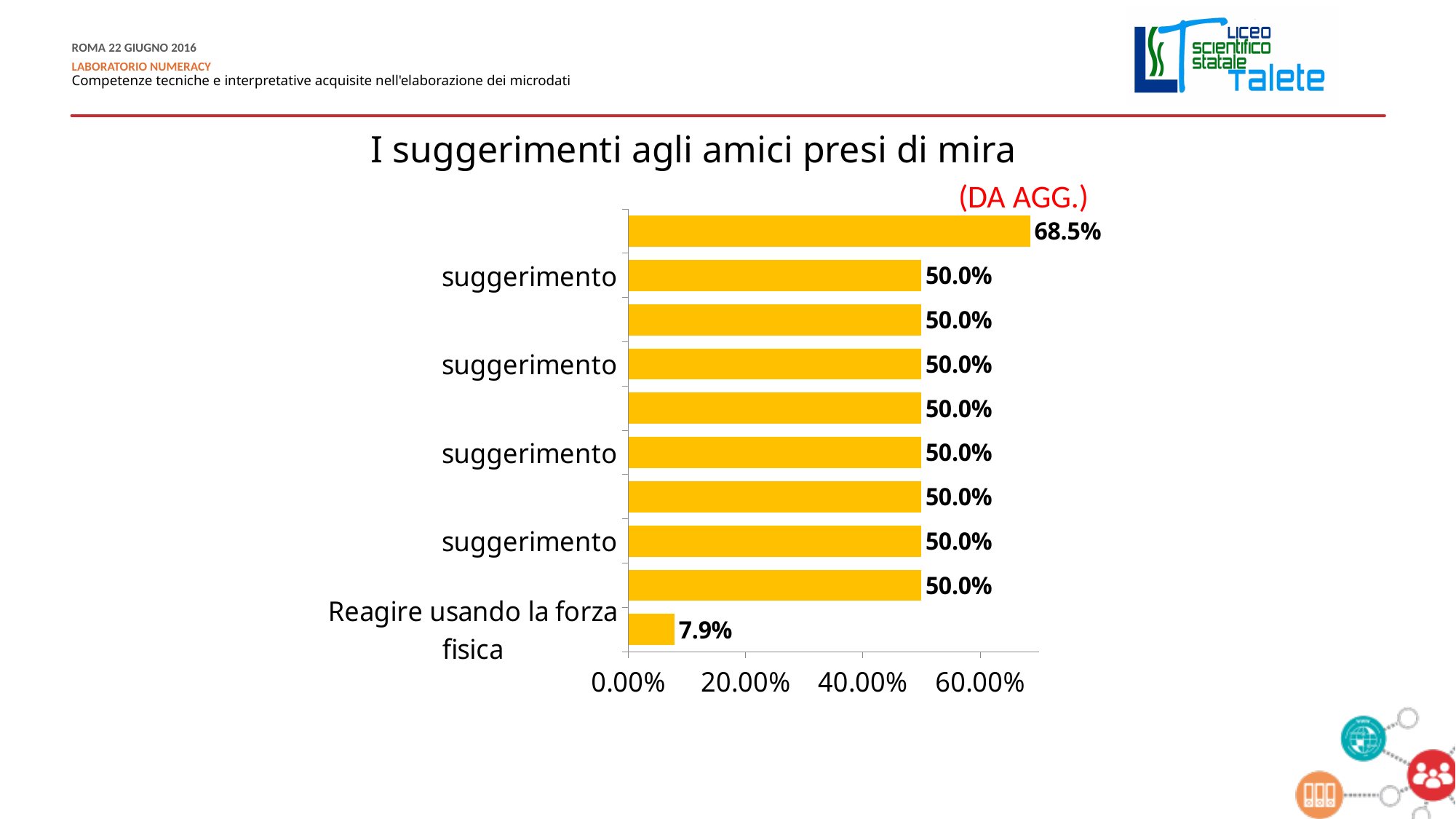
What is the difference between the highest value (68.5%) and the value for "Reagire usando la forza fisica"? 60.6 percentage points What is the title of the chart on the slide? I suggerimenti agli amici presi di mira What kind of chart is shown on the slide? Bar chart What is the difference between the top bar's value and the 50.0% bars? 18.5 percentage points Is the value for "Reagire usando la forza fisica" greater or less than 20.00%? less Which category has the lowest value in the chart? Reagire usando la forza fisica How many bars are plotted in the chart? 10 What value is shown for "Reagire usando la forza fisica"? 7.9% Is the value of the top bar greater or less than 60.00%? greater What is the highest value shown in the chart? 68.5% How many bars show a value of 50.0%? 8 What colour are the bars in the chart? Yellow